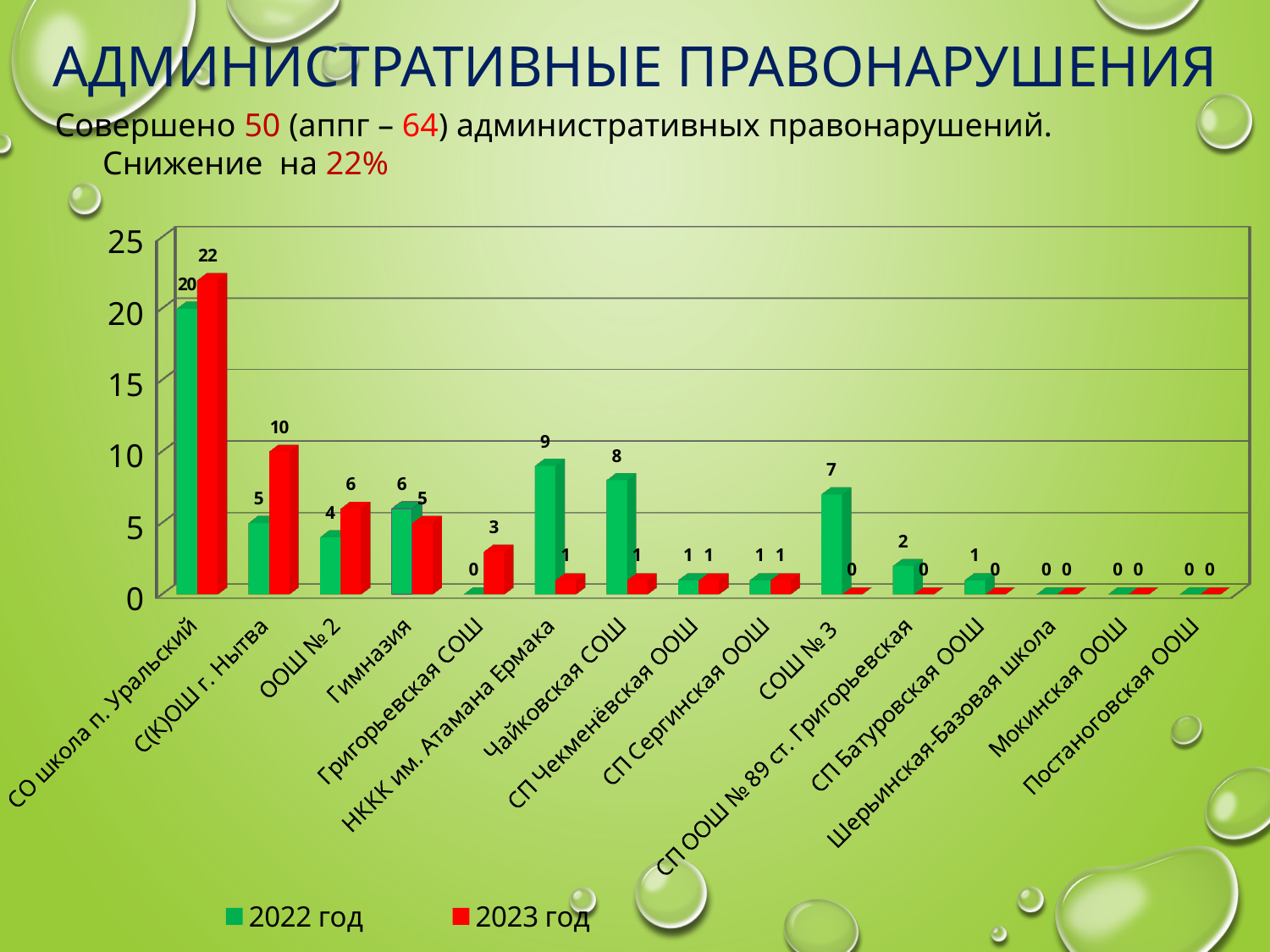
Is the 2023 год value for СО школа п. Уральский greater or less than 20? greater Which category has the highest value for 2022 год? СО школа п. Уральский What is the value for 2023 год for С(К)ОШ г. Нытва? 10 How many series does the legend list? 2 What is the value for 2023 год for СО школа п. Уральский? 22 What kind of chart is shown on the slide? bar chart Which colour represents the 2023 год series? red Which is larger for Гимназия: the 2022 год value or the 2023 год value? 2022 год What is the value for 2022 год for СОШ № 3? 7 What is the value for 2022 год for НККК им. Атамана Ермака? 9 How many categories are shown on the x axis? 15 What is the difference between the 2023 год and 2022 год values for С(К)ОШ г. Нытва? 5